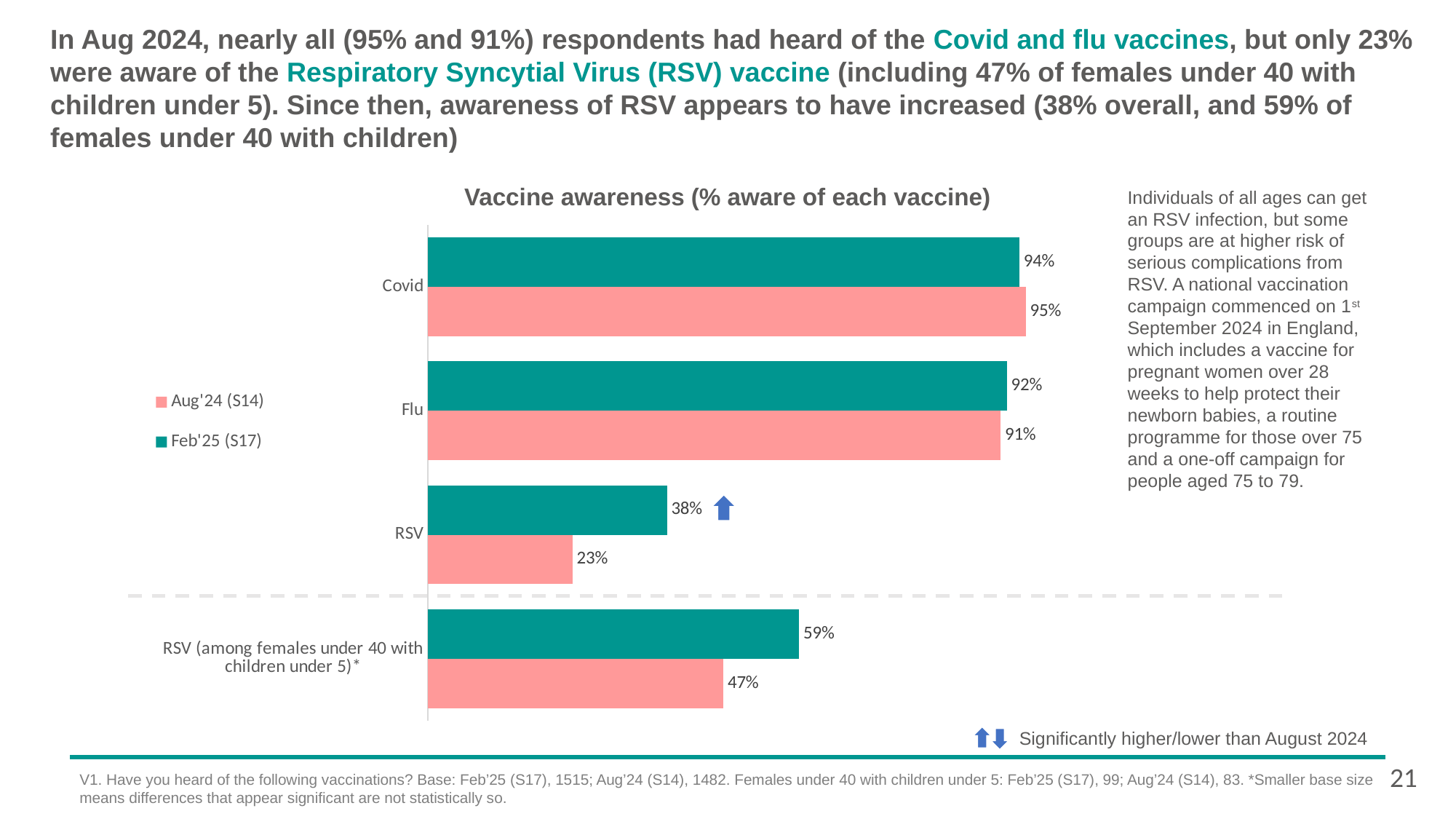
Which category has the highest Feb'25 (S17) awareness value? Covid What kind of chart is shown on the slide? bar chart What is the Aug'24 (S14) awareness value for the Covid vaccine? 95% What is the Feb'25 (S17) awareness value for the RSV vaccine? 38% What is the difference between the Feb'25 (S17) and Aug'24 (S14) values for RSV among females under 40 with children under 5? 12 percentage points How many categories are shown on the chart? 4 Is the Feb'25 (S17) value for Flu larger or smaller than the Aug'24 (S14) value for Flu? larger What is the Aug'24 (S14) awareness value for RSV among females under 40 with children under 5? 47% What is the difference between the Feb'25 (S17) and Aug'24 (S14) values for RSV? 15 percentage points How many series does the legend list? 2 Which category has the lowest Aug'24 (S14) awareness value? RSV What is the title of the chart? Vaccine awareness (% aware of each vaccine)